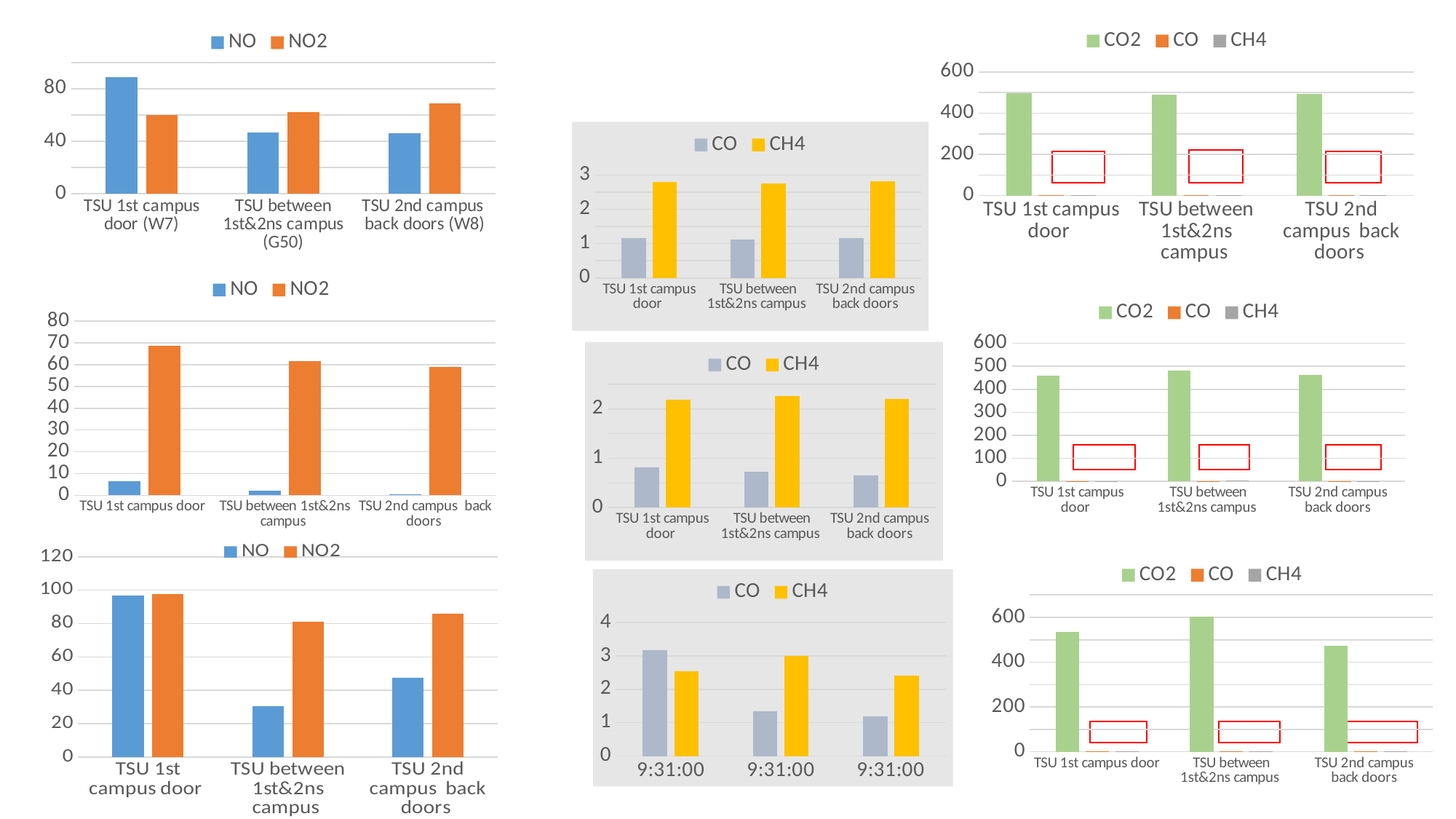
In the bottom chart of the middle column, do the CO values rise or fall from left to right along the x axis? fall In the top chart of the middle column, which is larger for TSU 1st campus door, CO or CH4? CH4 In the bottom-right chart, which category has the highest CO2 value? TSU between 1st&2ns campus In the top-left chart, is the NO value for TSU 1st campus door (W7) greater or less than 80? greater In the middle chart of the left column, which is larger for TSU 1st campus door, NO or NO2? NO2 In the top-left chart, how many series does the legend list? 2 In the middle chart of the right column, is the CO2 value for TSU 1st campus door greater or less than 400? greater In the bottom-left chart, is the NO value for TSU between 1st&2ns campus greater or less than 40? less In the top-right chart, how many series does the legend list? 3 In the top-left chart, which category has the highest NO value? TSU 1st campus door (W7) In the bottom-left chart, how many categories are shown on the x axis? 3